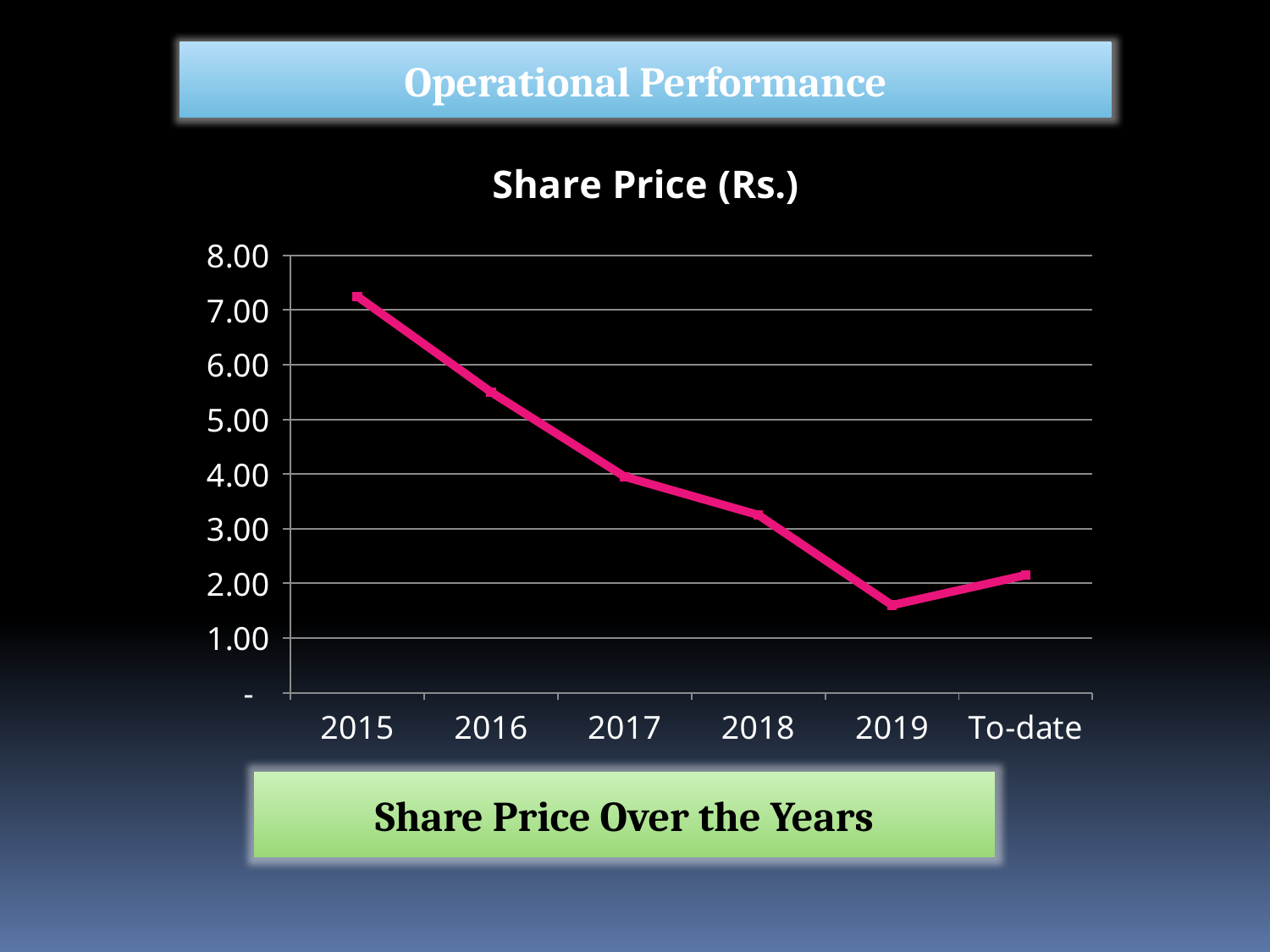
How many points are plotted along the x axis of the chart? 6 Is the share price for To-date greater or less than 3.00? less Which is larger, the share price for 2019 or for To-date? To-date What is the title of the chart? Share Price (Rs.) Which category has the lowest share price? 2019 Is the share price for 2016 greater or less than 5.00? greater Is the share price for 2019 greater or less than 2.00? less What type of chart is shown on the slide? line chart Which year has the highest share price? 2015 Does the share price rise or fall from 2015 to 2019? fall